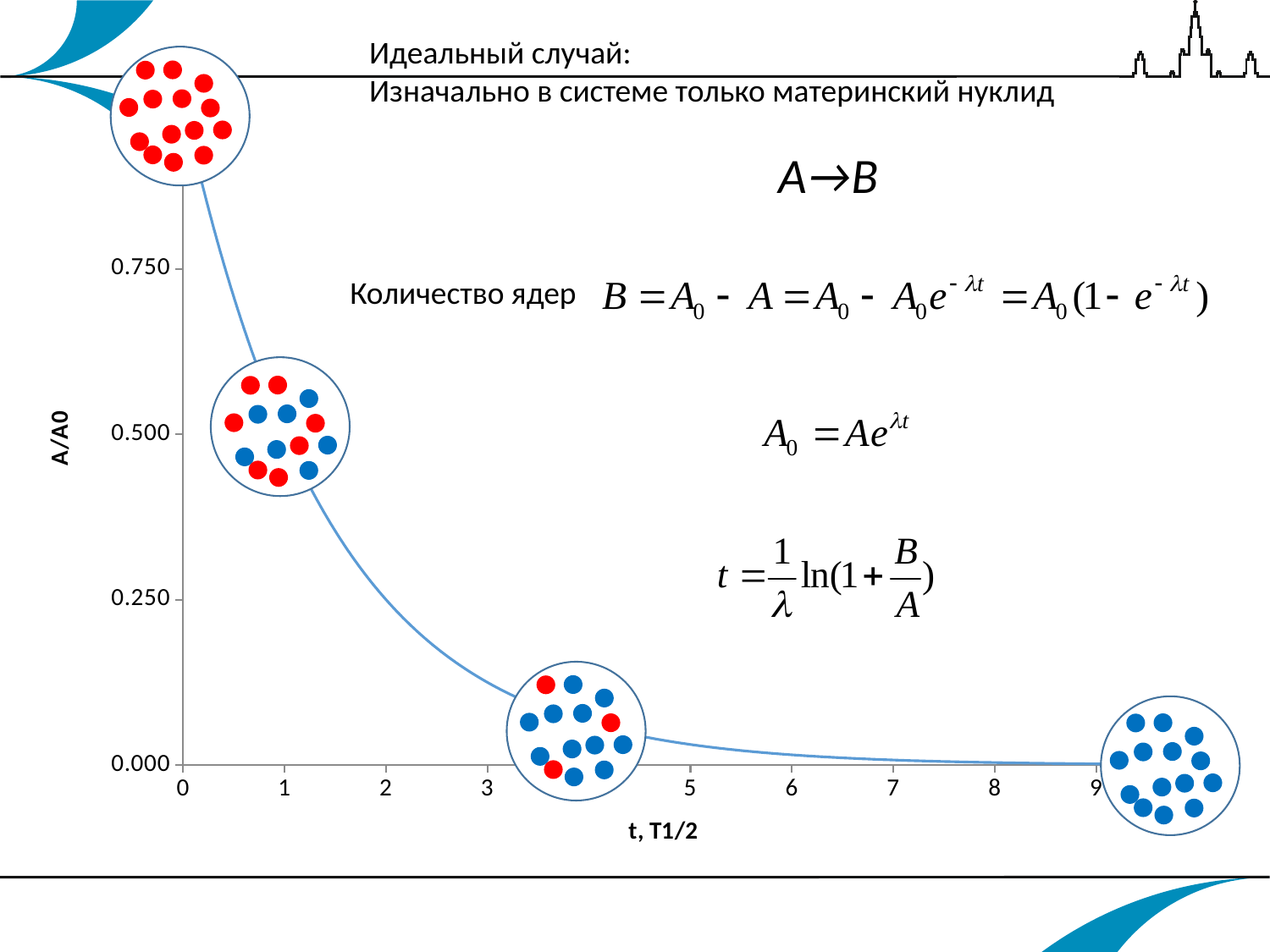
Is the value of A/A0 at t = 3 greater or less than 0.250? less What is the label of the y axis of the chart? A/A0 Is the value of A/A0 at t = 6 greater or less than 0.250? less Does the plotted value A/A0 rise or fall as t increases along the x axis? fall Is the value of A/A0 at t = 2 greater or less than 0.500? less What is the label of the x axis of the chart? t, T1/2 What kind of chart is shown on the slide? line chart How many tick labels are shown on the x axis? 9 At which value of t is A/A0 highest? 0 What is the value of A/A0 at t = 1? 0.500 Which is larger, the value of A/A0 at t = 1 or at t = 4? t = 1